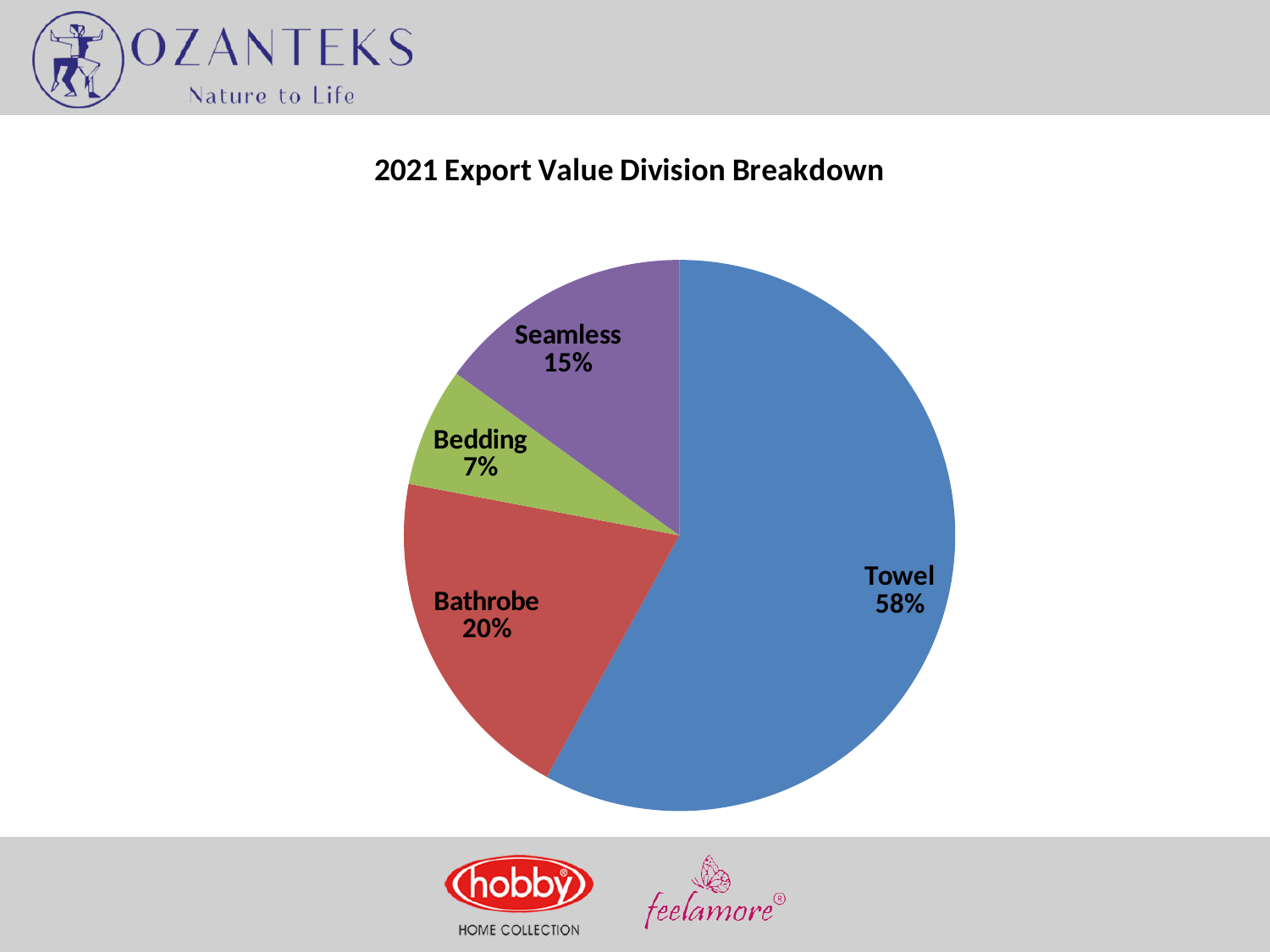
Which has a larger share, Bathrobe or Seamless? Bathrobe How many divisions are shown in the pie chart? 4 Which division has the largest share of the 2021 export value? Towel What share of the 2021 export value does Towel account for? 58% What percentage is shown for Bathrobe? 20% What kind of chart is shown on the slide? pie chart Which division has the smallest share of the 2021 export value? Bedding What percentage is shown for Seamless? 15% What is the difference in percentage points between Towel and Bathrobe? 38 What colour is the Towel slice? blue What percentage is shown for Bedding? 7% What is the title of the chart? 2021 Export Value Division Breakdown